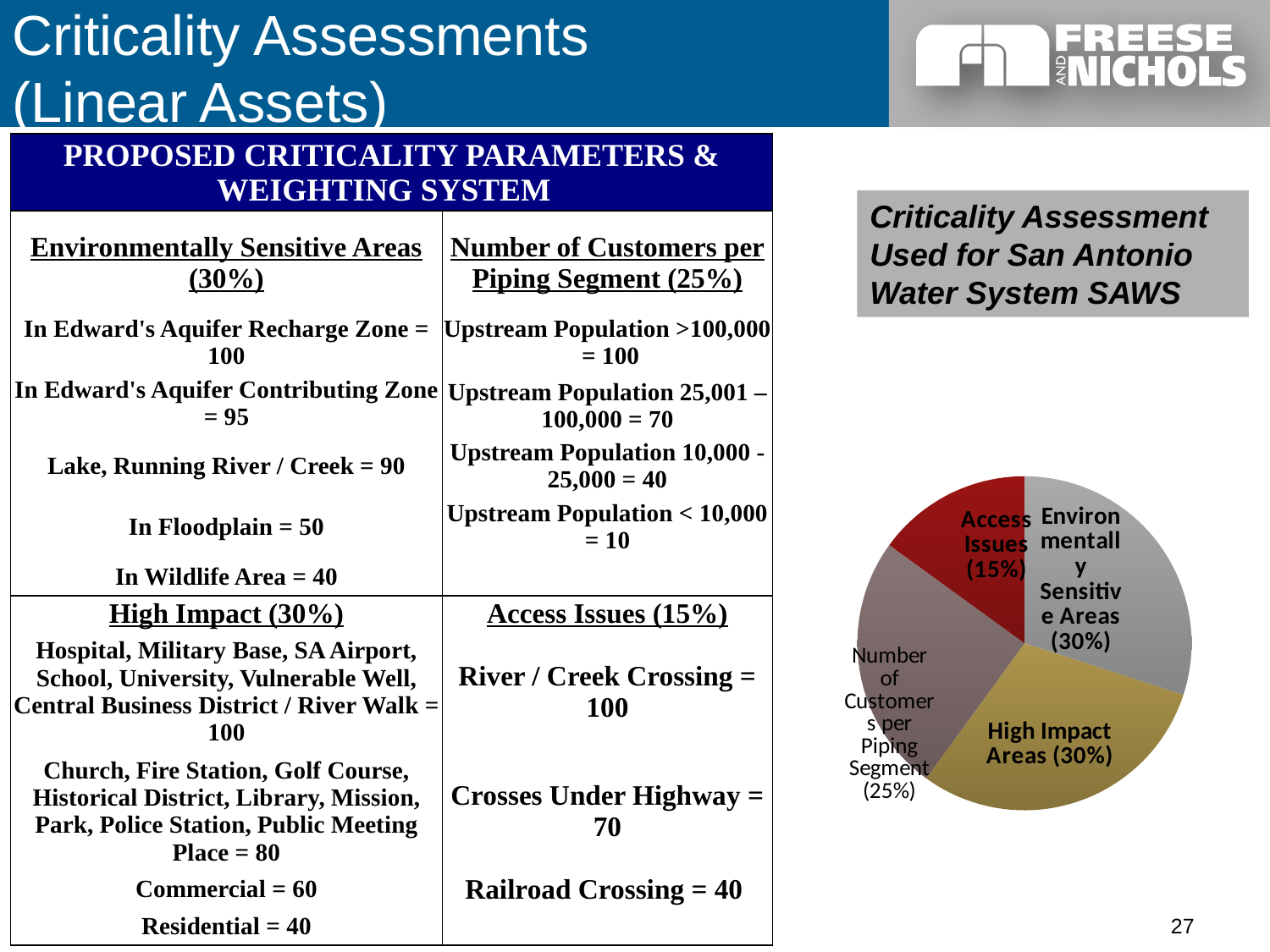
What colour is the Access Issues slice in the pie chart? red What kind of chart is shown on the slide? pie chart Which is larger in the pie chart, High Impact Areas or Access Issues? High Impact Areas Which is larger in the pie chart, Number of Customers per Piping Segment or Access Issues? Number of Customers per Piping Segment What share of the pie does Access Issues represent? 15% What is the value shown for High Impact Areas in the pie chart? 30% How many slices does the pie chart have? 4 Which slice of the pie chart is the smallest? Access Issues What is the value shown for Environmentally Sensitive Areas in the pie chart? 30% What is the difference between the shares for Environmentally Sensitive Areas and Access Issues? 15% What share of the pie does Number of Customers per Piping Segment represent? 25% What is the difference between the shares for High Impact Areas and Number of Customers per Piping Segment? 5%